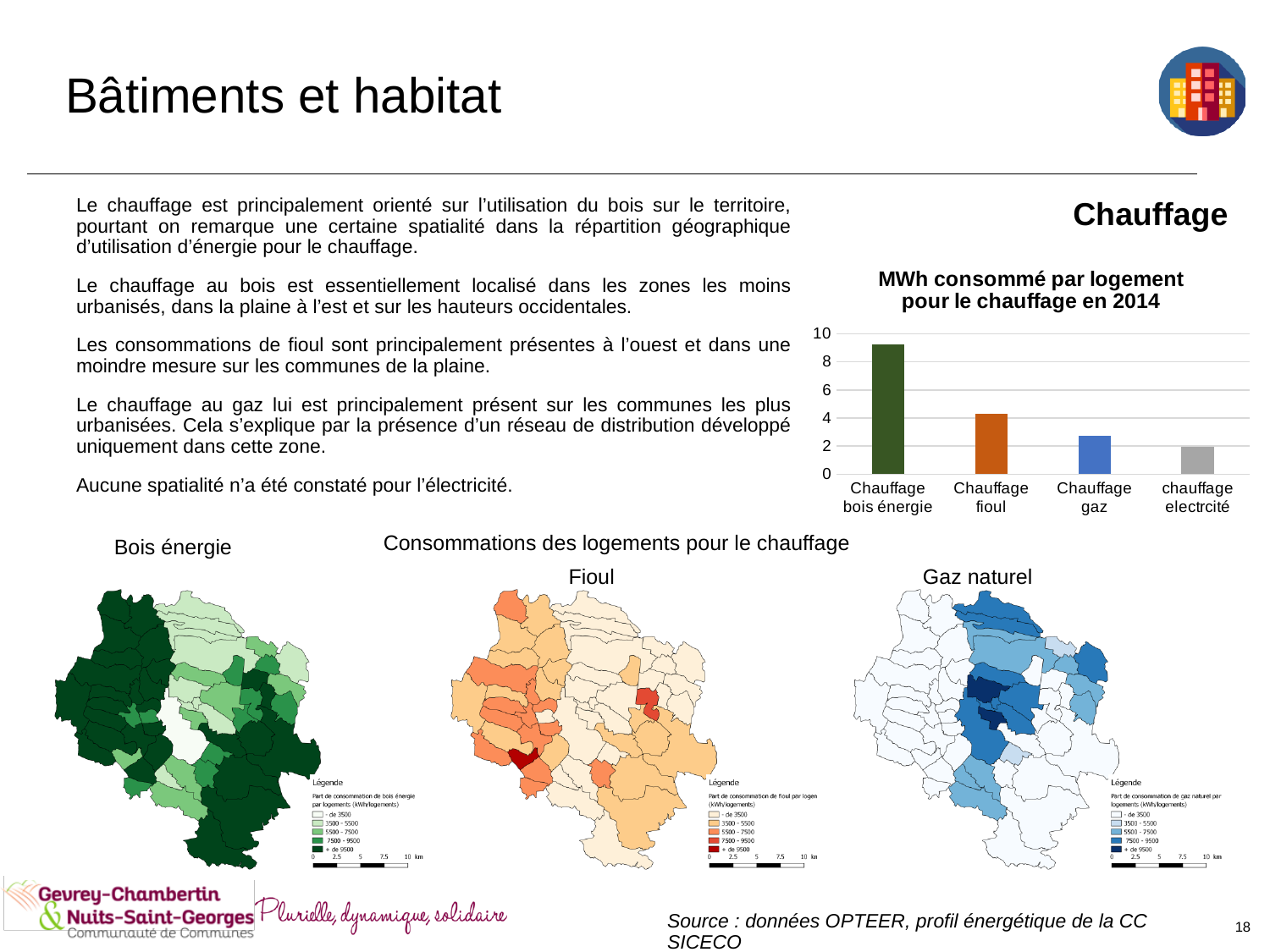
In the bar chart 'MWh consommé par logement pour le chauffage en 2014', which category has the lowest value? chauffage electrcité In the bar chart 'MWh consommé par logement pour le chauffage en 2014', do the values rise or fall from left to right across the categories? fall In the bar chart 'MWh consommé par logement pour le chauffage en 2014', which is larger: Chauffage bois énergie or Chauffage fioul? Chauffage bois énergie What kind of chart is 'MWh consommé par logement pour le chauffage en 2014'? bar chart In the bar chart 'MWh consommé par logement pour le chauffage en 2014', is the value for Chauffage fioul greater or less than 2? greater In the bar chart 'MWh consommé par logement pour le chauffage en 2014', is the value for Chauffage gaz greater or less than 4? less In the bar chart 'MWh consommé par logement pour le chauffage en 2014', is the value for Chauffage bois énergie greater or less than 8? greater In the bar chart 'MWh consommé par logement pour le chauffage en 2014', which is larger: Chauffage fioul or Chauffage gaz? Chauffage fioul What is the title of the bar chart on the slide? MWh consommé par logement pour le chauffage en 2014 In the bar chart 'MWh consommé par logement pour le chauffage en 2014', which category has the highest value? Chauffage bois énergie How many categories are shown in the bar chart 'MWh consommé par logement pour le chauffage en 2014'? 4